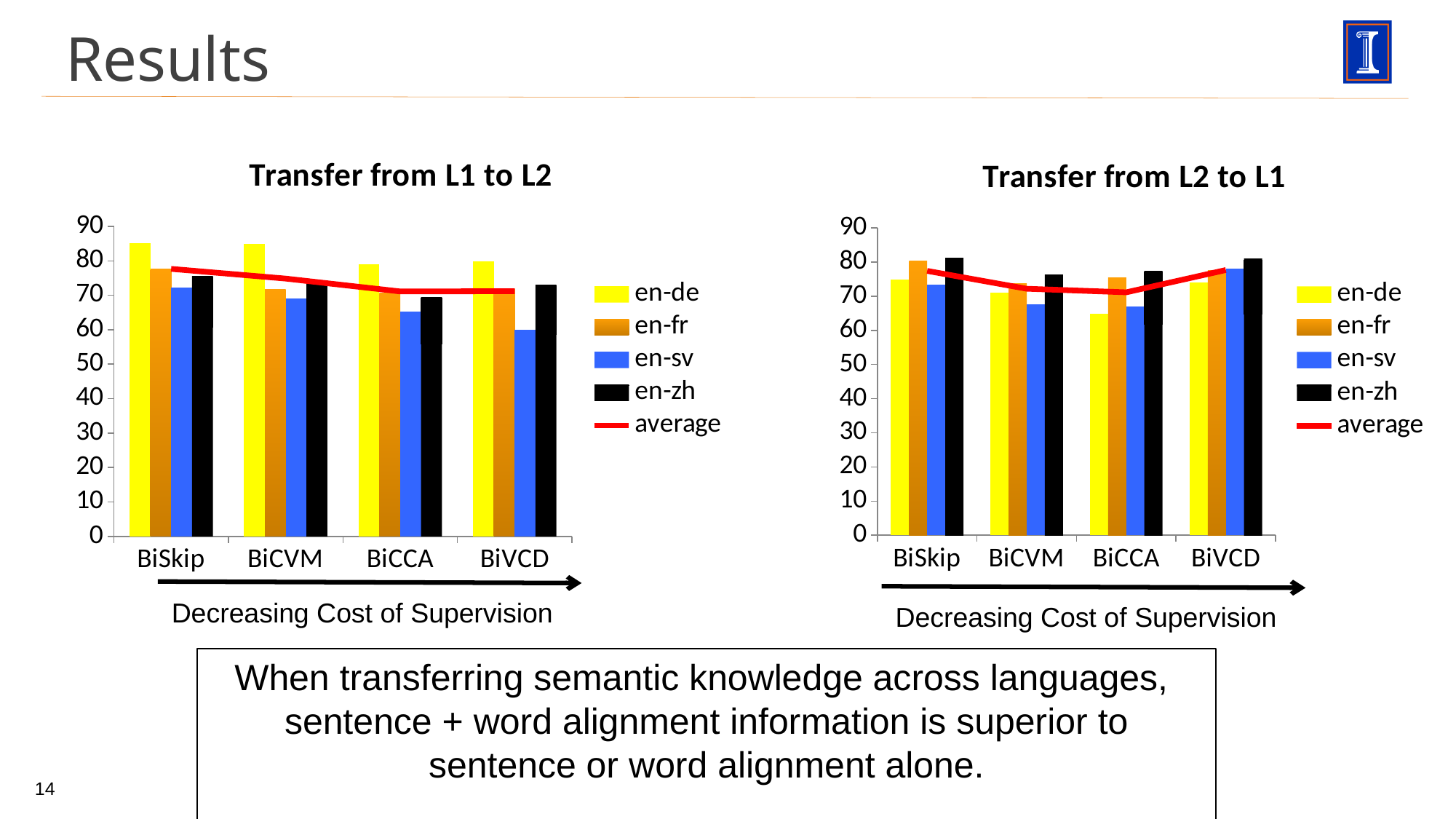
In the 'Transfer from L2 to L1' chart, what label appears under the x axis arrow? Decreasing Cost of Supervision In the 'Transfer from L1 to L2' chart, is the en-de value for BiSkip greater or less than 80? greater In the 'Transfer from L1 to L2' chart, how many entries does the legend list? 5 In the 'Transfer from L2 to L1' chart, which is larger for BiSkip, en-zh or en-de? en-zh In the 'Transfer from L2 to L1' chart, for which category is the en-de value lowest? BiCCA In the 'Transfer from L2 to L1' chart, how many categories are shown on the x axis? 4 In the 'Transfer from L1 to L2' chart, how many categories are shown on the x axis? 4 In the 'Transfer from L2 to L1' chart, is the en-de value for BiCCA greater or less than 70? less In the 'Transfer from L1 to L2' chart, for which category is the en-sv value lowest? BiVCD In the 'Transfer from L1 to L2' chart, which is larger for BiCCA, en-de or en-sv? en-de In the 'Transfer from L1 to L2' chart, is the en-sv value for BiVCD greater or less than 70? less In the 'Transfer from L1 to L2' chart, what kind of chart is used to show the language pairs? bar chart